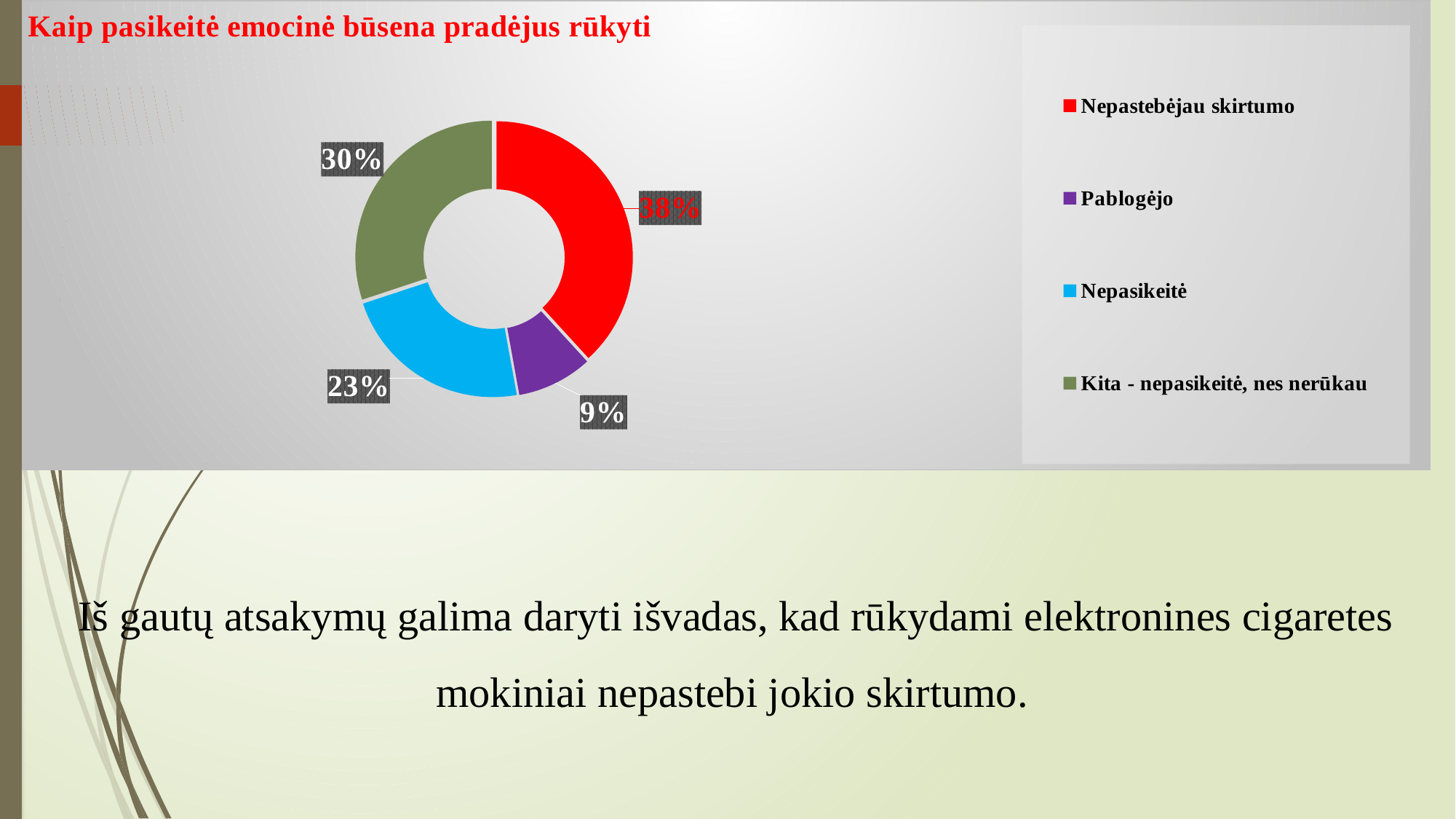
How many categories does the legend list? 4 What is the difference in percentage points between "Nepastebėjau skirtumo" and "Nepasikeitė"? 15 percentage points Which category has the smallest share of the chart? Pablogėjo What percentage of respondents answered "Nepastebėjau skirtumo"? 38% Which category has the largest share of the chart? Nepastebėjau skirtumo What is the title of the chart? Kaip pasikeitė emocinė būsena pradėjus rūkyti What kind of chart is shown on the slide? Doughnut (pie) chart Which is larger: the share for "Kita - nepasikeitė, nes nerūkau" or the share for "Nepasikeitė"? Kita - nepasikeitė, nes nerūkau What colour represents the "Nepasikeitė" category in the chart? Blue What percentage of respondents answered "Pablogėjo"? 9% What percentage of respondents answered "Nepasikeitė"? 23% What percentage of respondents answered "Kita - nepasikeitė, nes nerūkau"? 30%